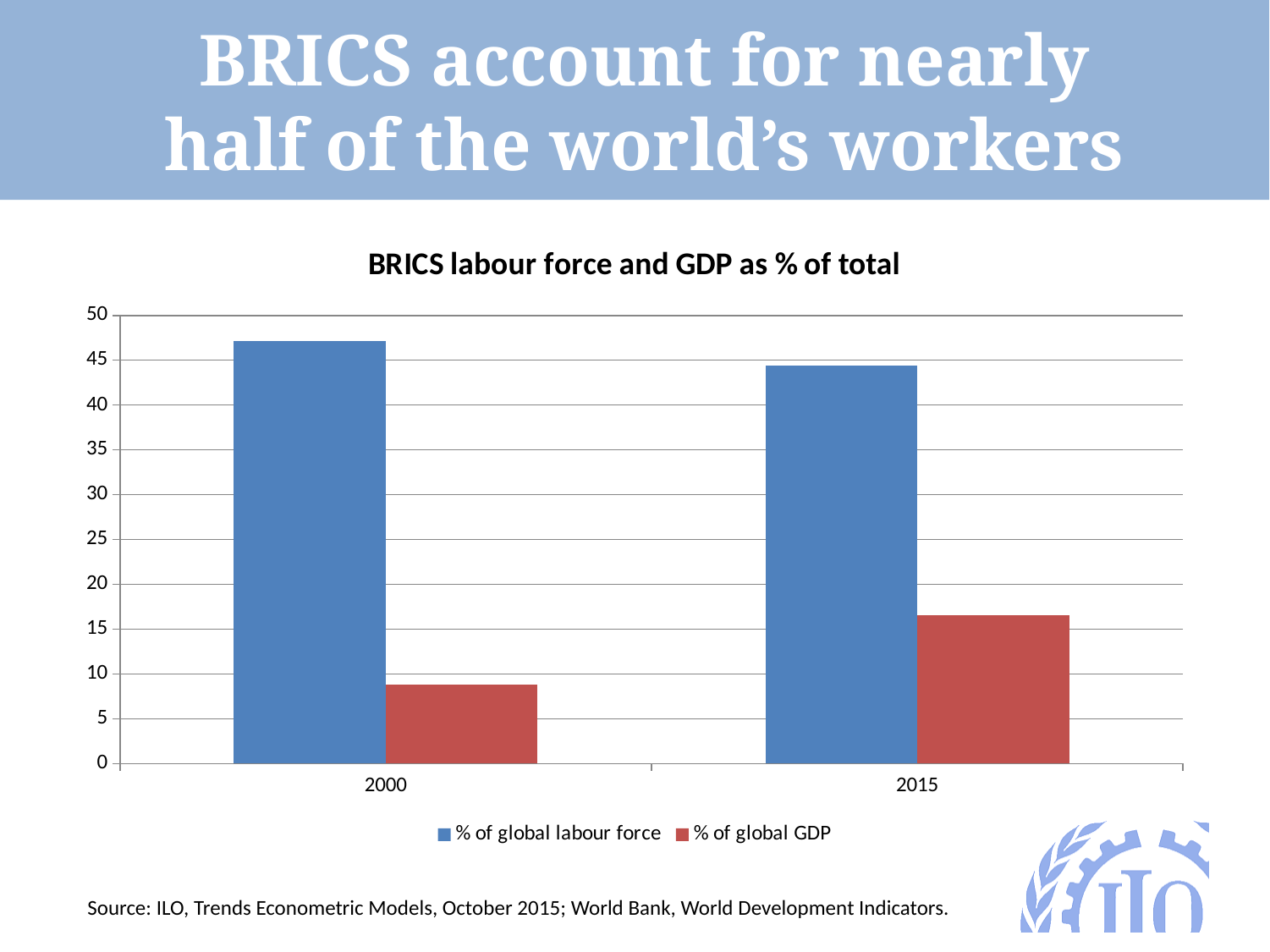
Which series is shown in red? % of global GDP Does the % of global GDP rise or fall from 2000 to 2015? rise Is the value for % of global labour force in 2015 greater or less than 45? less What is the title of the chart? BRICS labour force and GDP as % of total How many years are shown on the x axis? 2 Is the value for % of global GDP in 2015 greater or less than 15? greater Does the % of global labour force rise or fall from 2000 to 2015? fall Is the value for % of global labour force in 2000 greater or less than 45? greater Which is larger, % of global GDP in 2000 or % of global GDP in 2015? 2015 How many series does the legend list? 2 What kind of chart is shown on the slide? bar chart